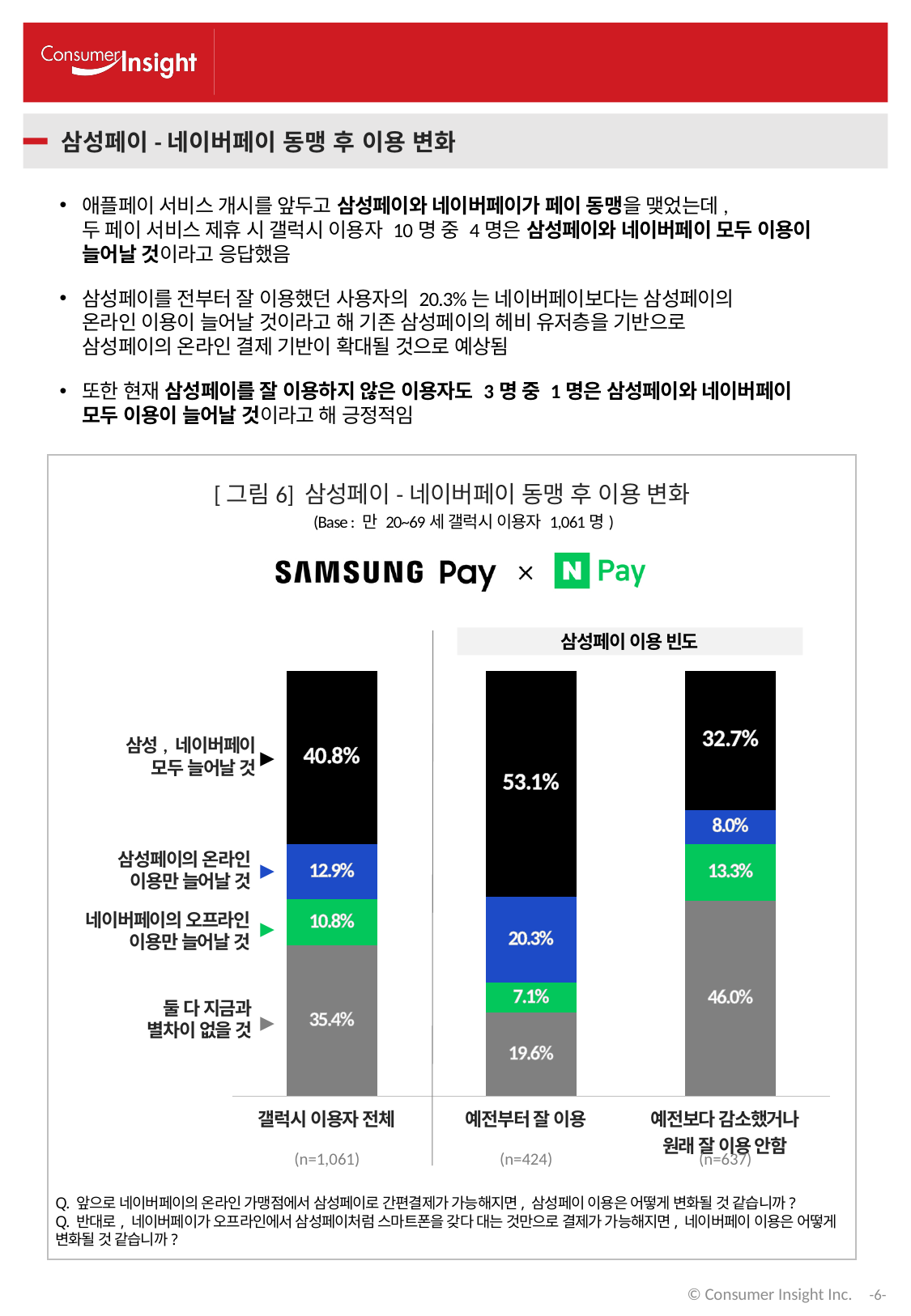
In [그림 6], which is larger for the 갤럭시 이용자 전체 group: 삼성페이의 온라인 이용만 늘어날 것 or 네이버페이의 오프라인 이용만 늘어날 것? 삼성페이의 온라인 이용만 늘어날 것 How many response categories (segments) make up each bar in [그림 6]? 4 In [그림 6], what is the value of 네이버페이의 오프라인 이용만 늘어날 것 for the 예전부터 잘 이용 group? 7.1% In [그림 6], what is the sample size (n) for the 예전부터 잘 이용 group? n=424 In [그림 6], what is the value of 삼성페이의 온라인 이용만 늘어날 것 for the 예전부터 잘 이용 group? 20.3% In [그림 6], what is the value of 둘 다 지금과 별차이 없을 것 for the 예전보다 감소했거나 원래 잘 이용 안함 group? 46.0% How many groups (bars) are shown in [그림 6]? 3 In [그림 6], which group has the highest share of 삼성, 네이버페이 모두 늘어날 것? 예전부터 잘 이용 In [그림 6], what is the difference between the 삼성, 네이버페이 모두 늘어날 것 share for 예전부터 잘 이용 and for 예전보다 감소했거나 원래 잘 이용 안함? 20.4 percentage points What type of chart is shown in [그림 6]? stacked bar chart In [그림 6], which group has the lowest share of 둘 다 지금과 별차이 없을 것? 예전부터 잘 이용 In [그림 6], what percentage of 갤럭시 이용자 전체 answered 삼성, 네이버페이 모두 늘어날 것? 40.8%